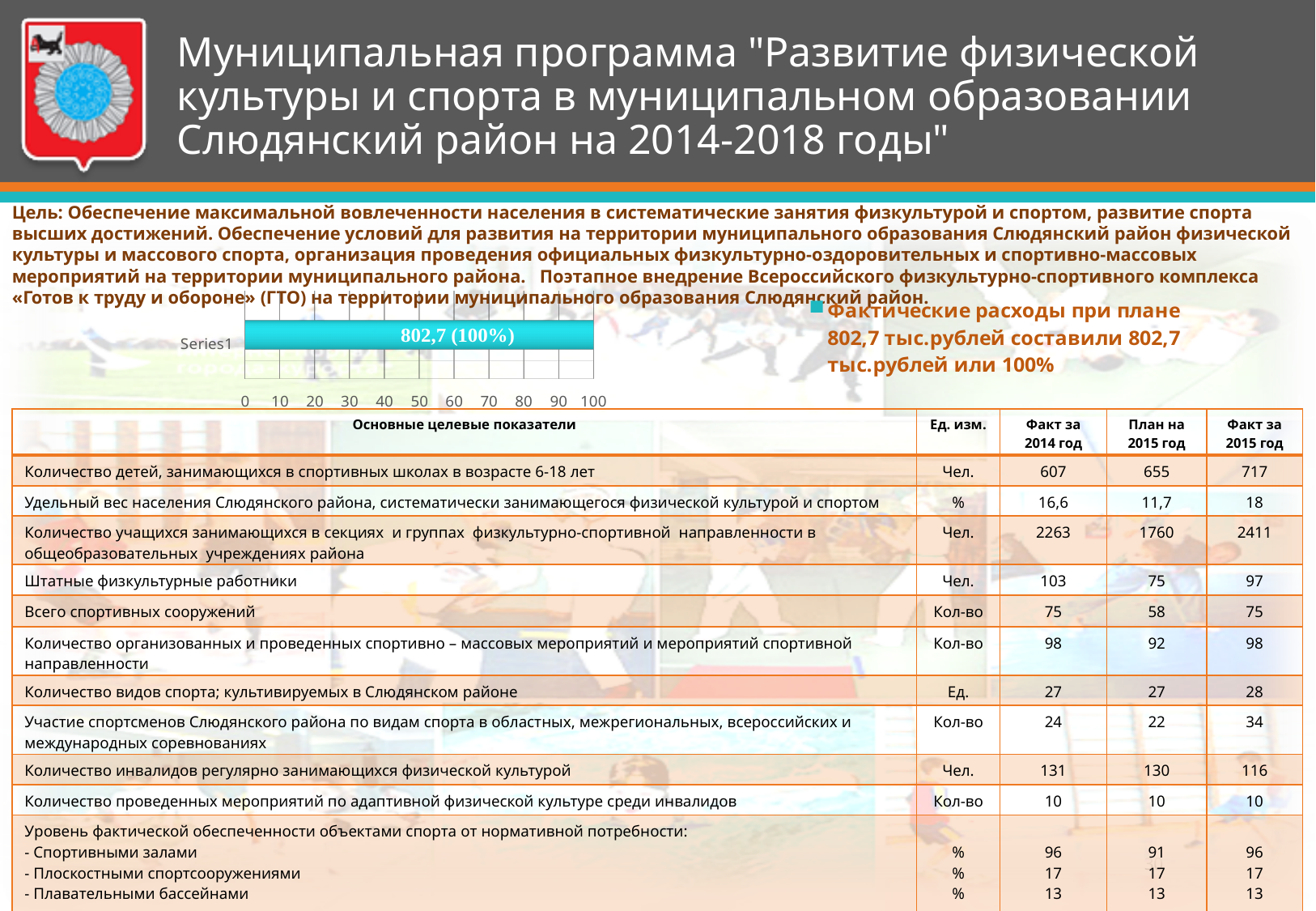
What is the category label shown next to the bar in the chart? Series1 What data label is printed on the bar in the chart? 802,7 (100%) How many bars does the chart show? 1 Is the value for Series1 on the chart's axis greater or less than 50? greater What percentage is shown in the data label on the bar? 100% What kind of chart is shown on the slide? bar chart What is the highest tick value shown on the chart's horizontal axis? 100